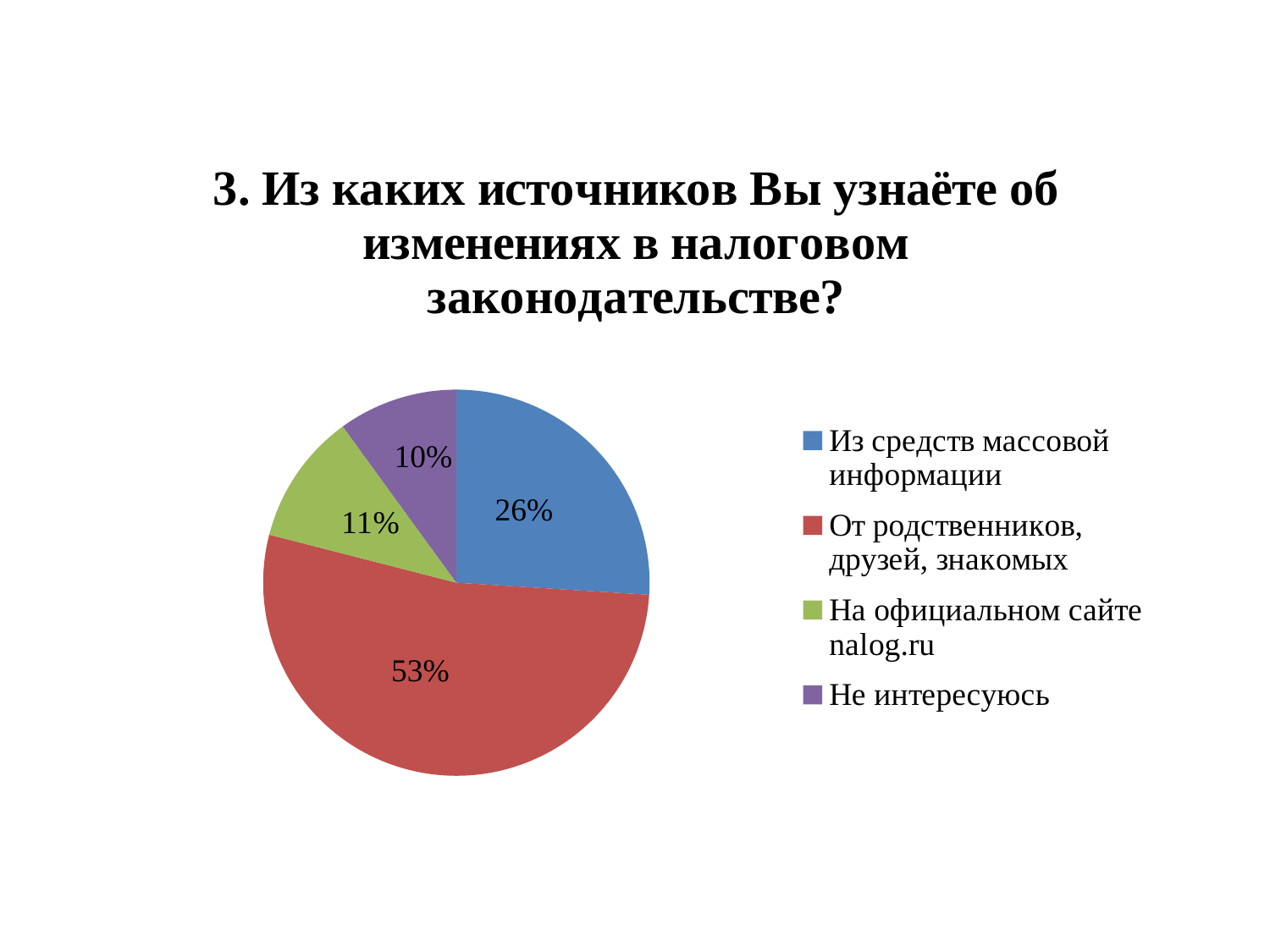
What kind of chart is shown on the slide? Pie chart Which category has the largest slice of the pie? От родственников, друзей, знакомых What is the combined share of 'На официальном сайте nalog.ru' and 'Не интересуюсь'? 21% What share of the pie is 'На официальном сайте nalog.ru'? 11% How many categories does the pie chart show? 4 What is the difference in percentage points between 'От родственников, друзей, знакомых' and 'Из средств массовой информации'? 27 Which is larger: the share for 'Из средств массовой информации' or for 'На официальном сайте nalog.ru'? Из средств массовой информации What share of the pie is 'Не интересуюсь'? 10% What share of the pie is 'От родственников, друзей, знакомых'? 53% Which category has the smallest slice of the pie? Не интересуюсь What colour is the slice for 'На официальном сайте nalog.ru'? Green